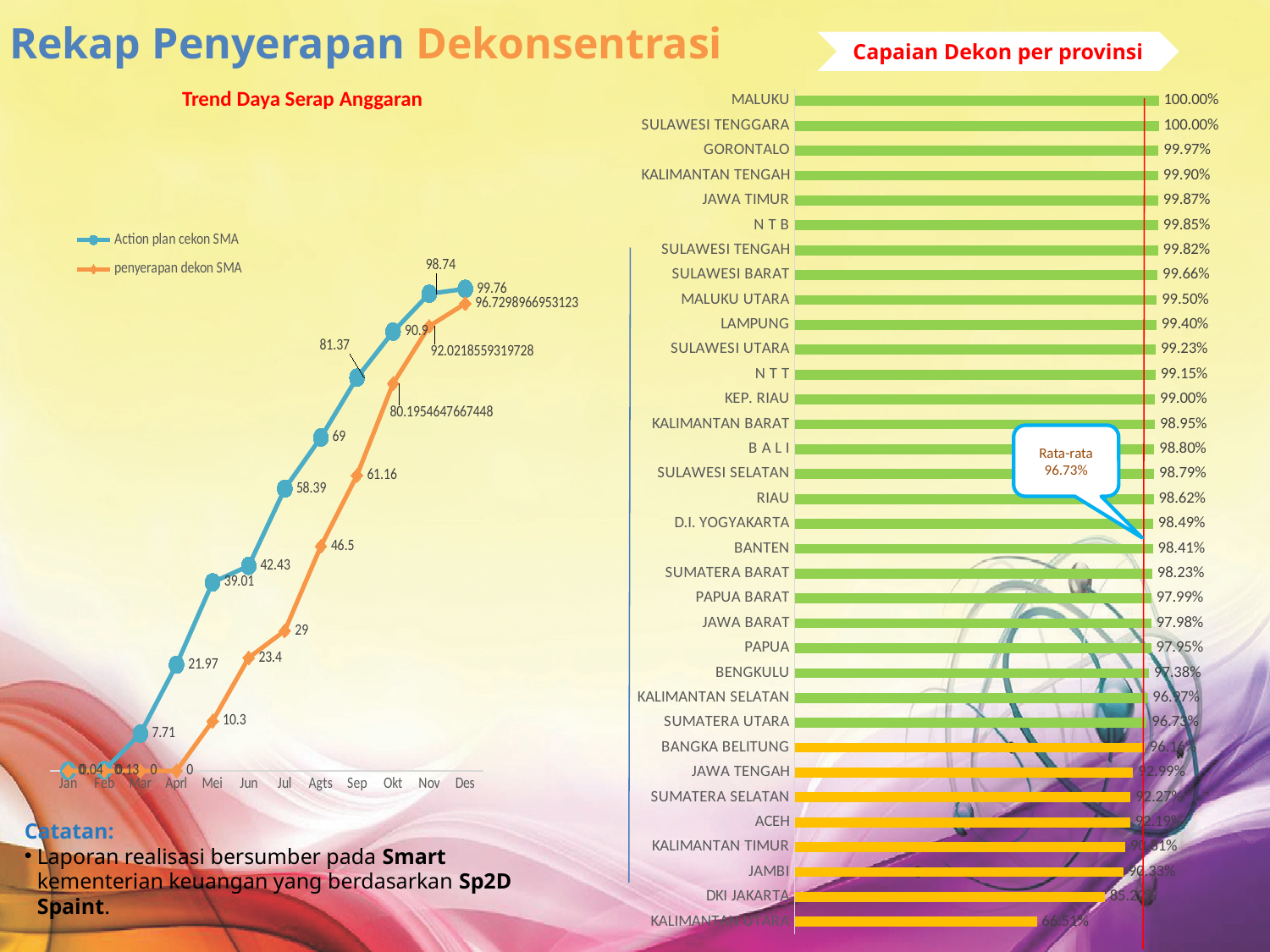
In the 'Capaian Dekon per provinsi' chart, what is the value for GORONTALO? 99.97% In the 'Capaian Dekon per provinsi' chart, which province has the lowest value? KALIMANTAN UTARA In the 'Capaian Dekon per provinsi' chart, what is the value for KEP. RIAU? 99.00% In the 'Trend Daya Serap Anggaran' chart, how many series does the legend list? 2 In the 'Capaian Dekon per provinsi' chart, what average (Rata-rata) value is shown in the callout? 96.73% In the 'Trend Daya Serap Anggaran' chart, what is the value of 'Action plan cekon SMA' for Des? 99.76 In the 'Capaian Dekon per provinsi' chart, what is the difference between the values for JAWA TIMUR and BANTEN? 1.46% In the 'Capaian Dekon per provinsi' chart, how many provinces are listed? 34 In the 'Trend Daya Serap Anggaran' chart, do the values of 'Action plan cekon SMA' rise or fall from Jan to Des? Rise In the 'Trend Daya Serap Anggaran' chart, what is the value of 'penyerapan dekon SMA' for Sep? 61.16 In the 'Capaian Dekon per provinsi' chart, which is larger, the value for LAMPUNG or the value for RIAU? LAMPUNG What kind of chart is 'Trend Daya Serap Anggaran'? Line chart